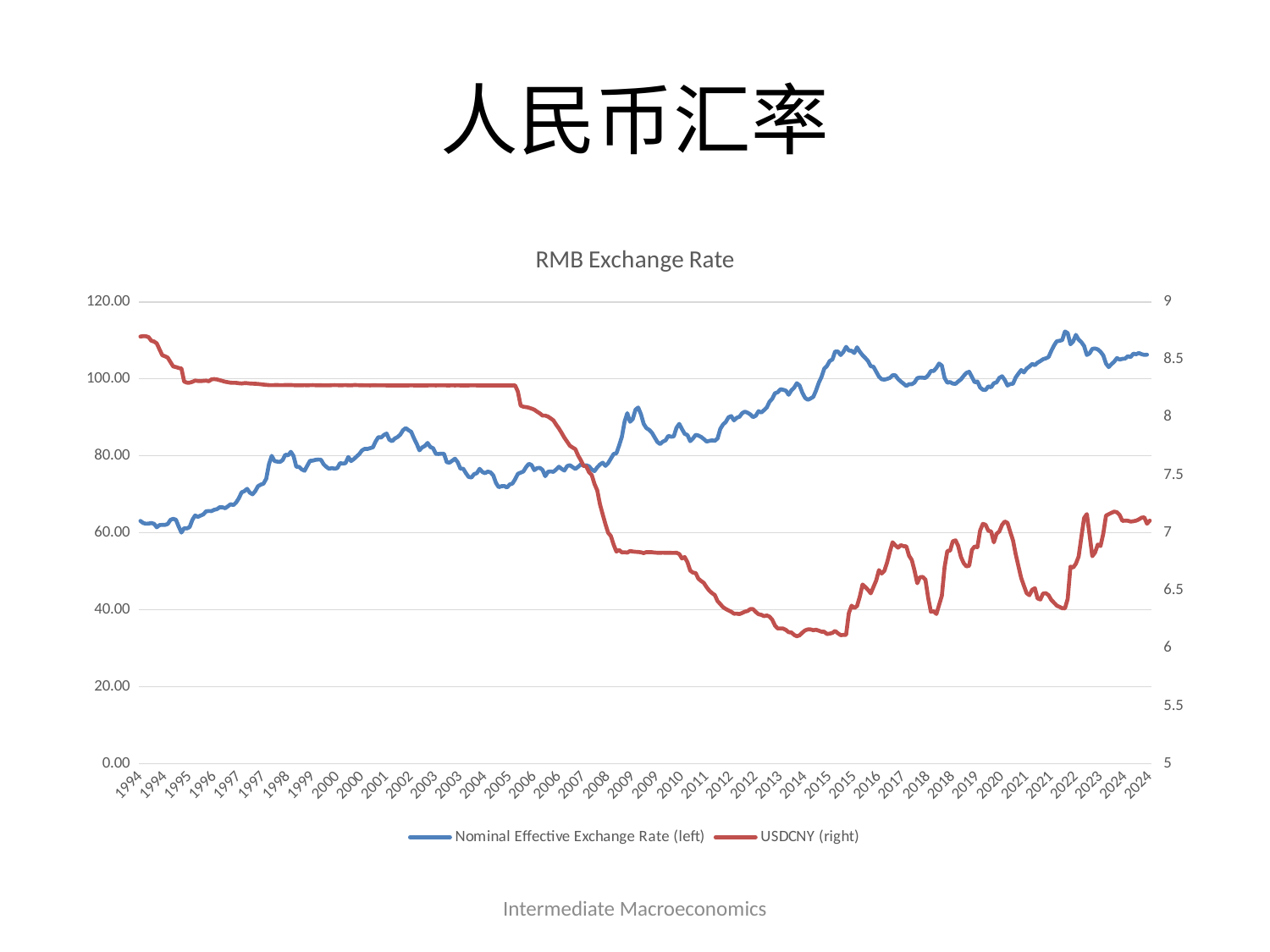
Does the Nominal Effective Exchange Rate series rise or fall overall from 1994 to 2024? rise How many series does the legend list? 2 Is the USDCNY value in 2014 greater or less than 6.5? less Does the USDCNY series rise or fall between 2005 and 2014? fall Is the USDCNY value in 2000 greater or less than 8? greater Is the value of the Nominal Effective Exchange Rate at the start of 1994 greater or less than 80.00? less Does the USDCNY series rise or fall between 2014 and 2017? rise What is the title of the chart? RMB Exchange Rate What kind of chart is shown on the slide? line chart Which series is plotted against the right axis according to the legend? USDCNY (right)